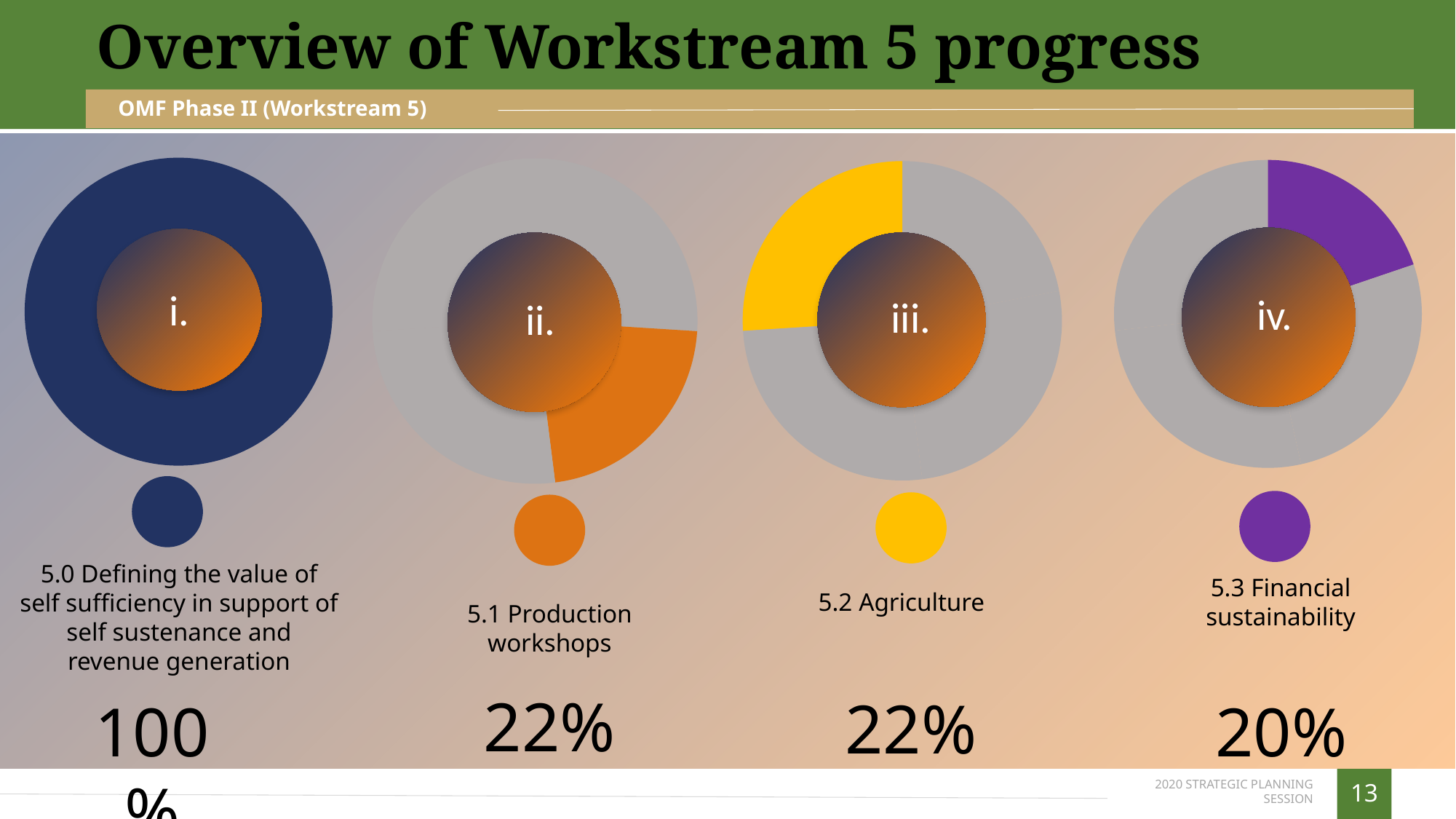
What progress value is shown for 5.1 Production workshops? 22% How many workstream items are shown as charts on the slide? 4 Which has a larger progress value, 5.2 Agriculture or 5.3 Financial sustainability? 5.2 Agriculture What progress value is shown for 5.2 Agriculture? 22% What kind of chart is used to show the progress of each workstream item? Pie chart (donut) What colour represents the progress of 5.2 Agriculture? Yellow Which workstream item shows the highest progress value? 5.0 Defining the value of self sufficiency in support of self sustenance and revenue generation What progress value is shown for 5.3 Financial sustainability? 20% Which workstream item shows the lowest progress value? 5.3 Financial sustainability What is the difference between the progress value for 5.0 and the progress value for 5.3 Financial sustainability? 80% What is the difference between the progress value for 5.1 Production workshops and 5.3 Financial sustainability? 2% What progress value is shown for 5.0 Defining the value of self sufficiency in support of self sustenance and revenue generation? 100%